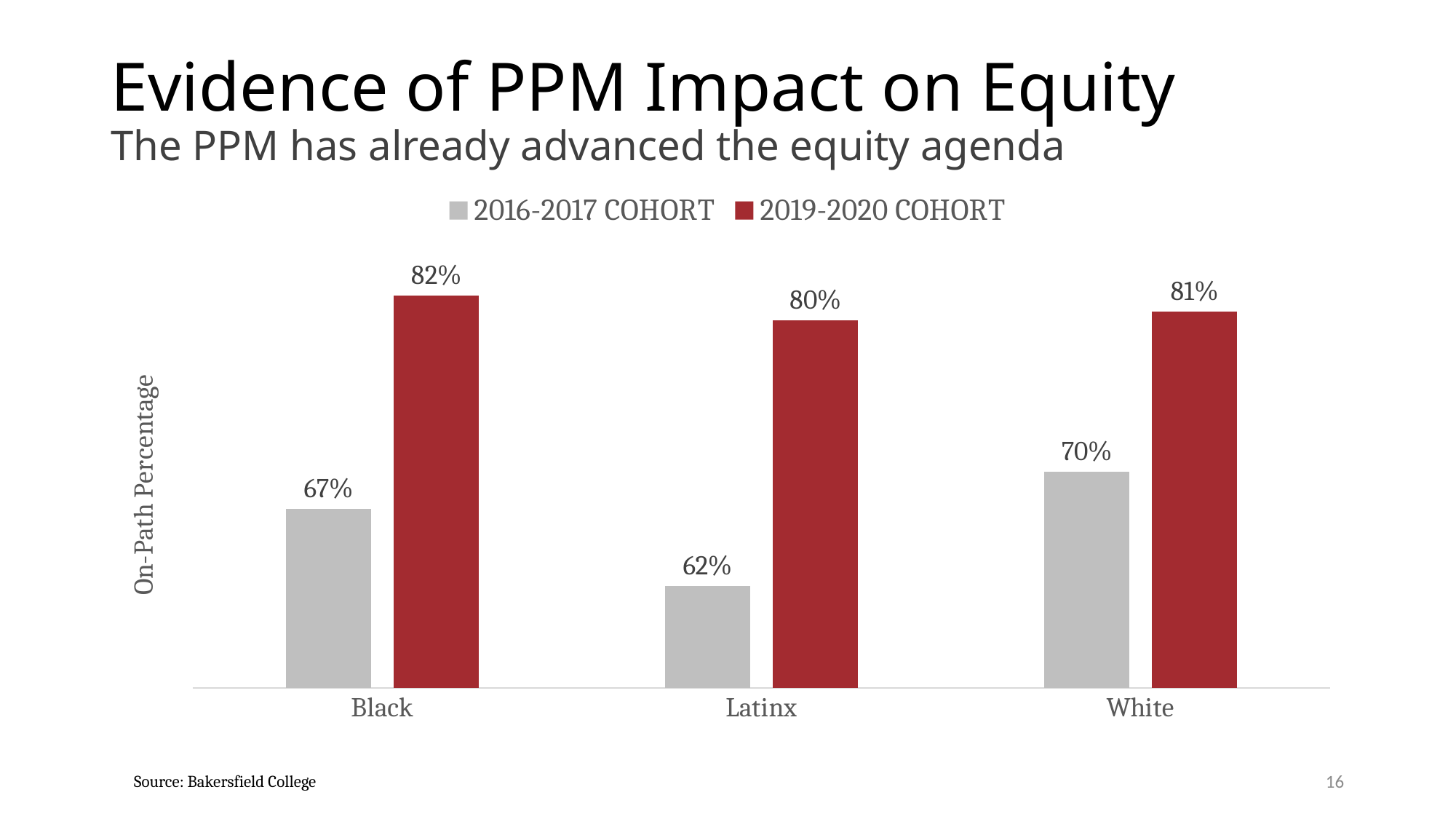
What is the on-path percentage for the White 2016-2017 cohort? 70% Which is larger: the 2016-2017 cohort value for White students or for Black students? White What kind of chart is shown on the slide? Bar chart What is the on-path percentage for the Latinx 2019-2020 cohort? 80% What is the label of the y axis? On-Path Percentage How many series does the legend list? 2 What is the difference between the 2019-2020 and 2016-2017 cohort on-path percentages for Latinx students? 18% What is the on-path percentage for the Black 2016-2017 cohort? 67% Which group has the highest on-path percentage in the 2019-2020 cohort? Black How many groups are shown on the x axis? 3 Which group has the lowest on-path percentage in the 2016-2017 cohort? Latinx What is the difference between the 2019-2020 and 2016-2017 cohort on-path percentages for Black students? 15%